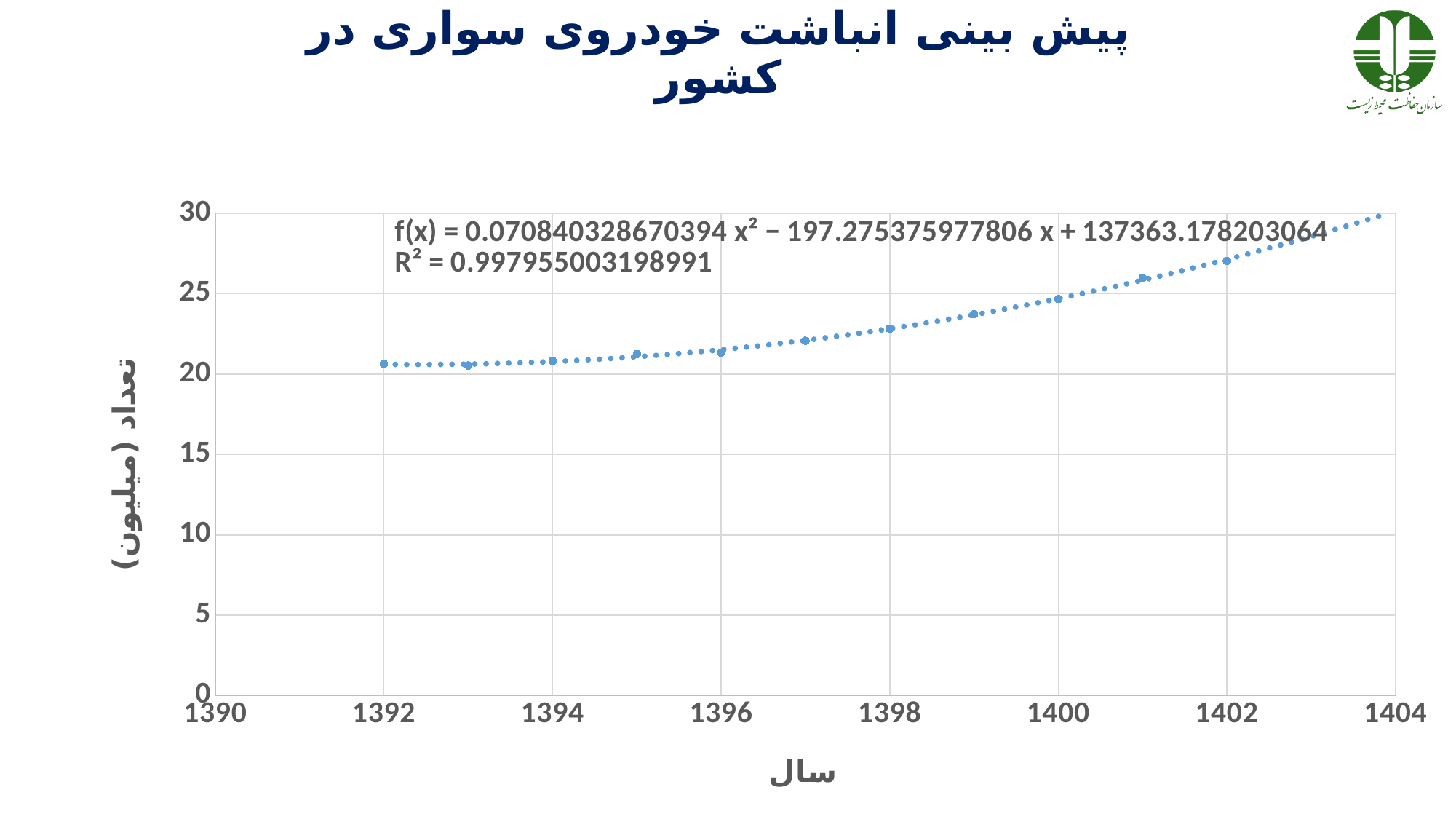
Is the value for 1402 greater or less than 25? greater Is the value for 1392 greater or less than 20? greater What is the label of the x axis? سال Which is larger, the value for 1400 or the value for 1396? 1400 Which year has the highest plotted value? 1402 Do the plotted values rise or fall as the year increases along the x axis? rise Is the value for 1396 greater or less than 25? less What kind of chart is shown on the slide? scatter chart Which is larger, the value for 1394 or the value for 1399? 1399 What R² value is printed on the chart for the trendline? 0.997955003198991